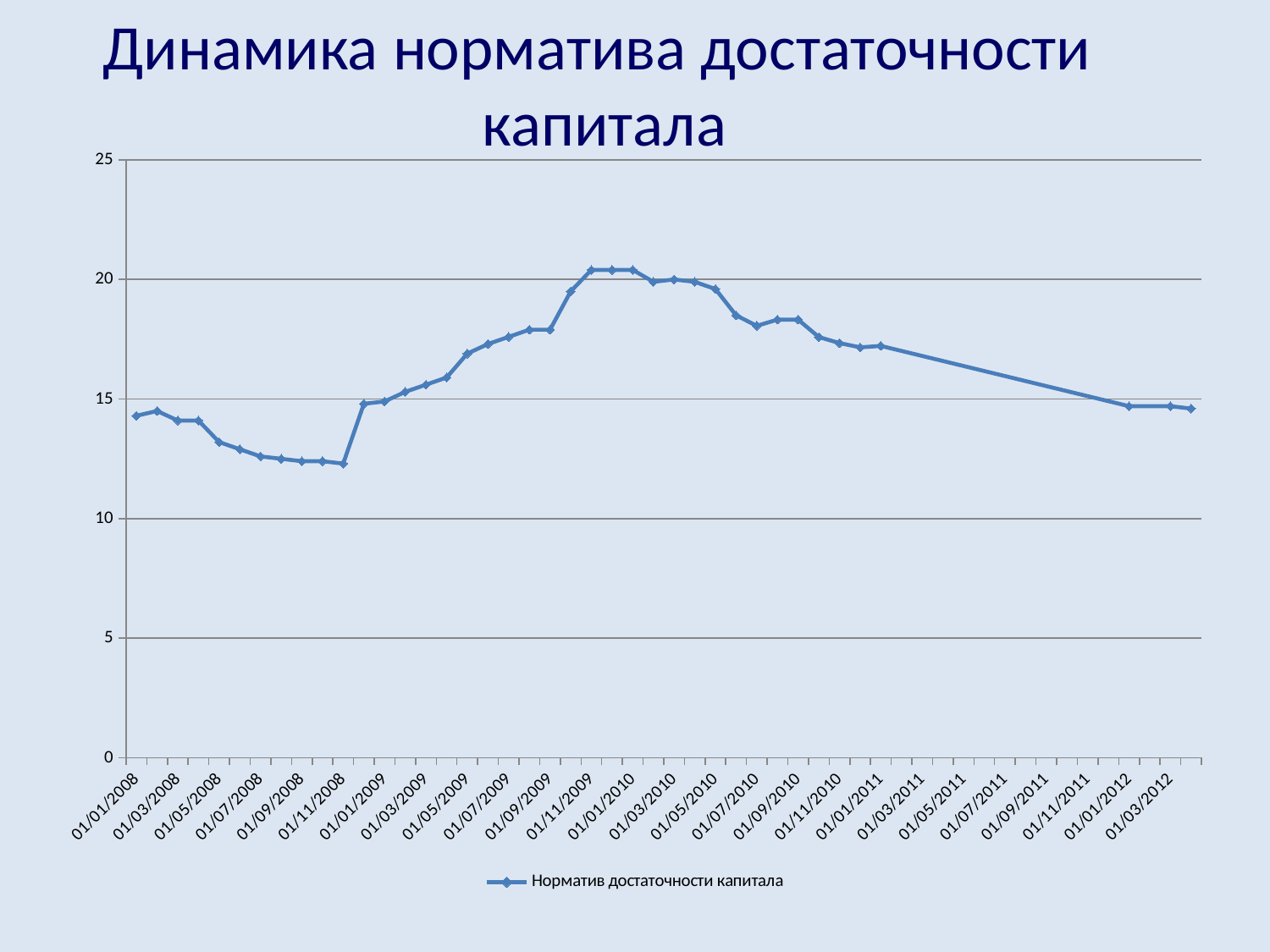
Is the value for 01/07/2009 greater or less than 15? greater Do the values rise or fall between 01/01/2008 and 01/11/2008? fall How many series does the legend list? 1 Is the value for 01/01/2010 greater or less than 20? greater Which is larger, the value for 01/01/2008 or the value for 01/01/2010? 01/01/2010 What kind of chart is shown on the slide? line chart What is the name of the series shown in the legend? Норматив достаточности капитала What is the title of the chart? Динамика норматива достаточности капитала Is the value for 01/09/2010 greater or less than 20? less Which is larger, the value for 01/11/2008 or the value for 01/01/2009? 01/01/2009 Do the values rise or fall between 01/01/2010 and 01/01/2012? fall